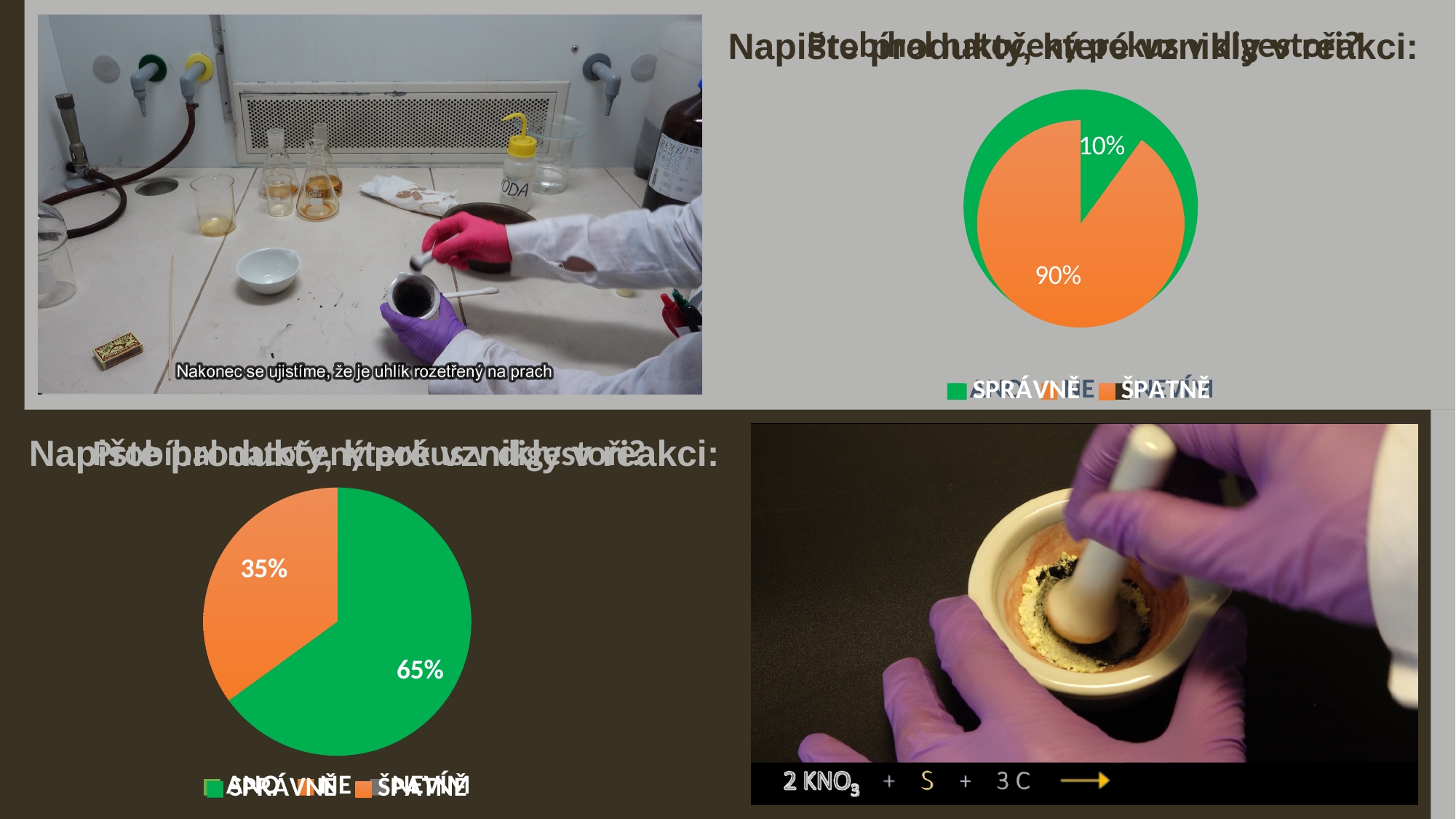
In the bottom-left pie chart, what share does the green slice have? 65% In the top-right pie chart, what share does the green slice (SPRÁVNĚ) have? 10% In the top-right pie chart, which slice is larger, the green one or the orange one? the orange one How many slices does the top-right pie chart have? 2 What kind of chart is the bottom-left chart? pie chart In the bottom-left pie chart, what share does the orange slice have? 35% In the bottom-left pie chart, which slice is the largest? the green slice (65%) What kind of chart is the top-right chart? pie chart In the top-right pie chart, what is the difference between the orange slice and the green slice? 80% In the bottom-left pie chart, what is the difference between the green slice and the orange slice? 30%